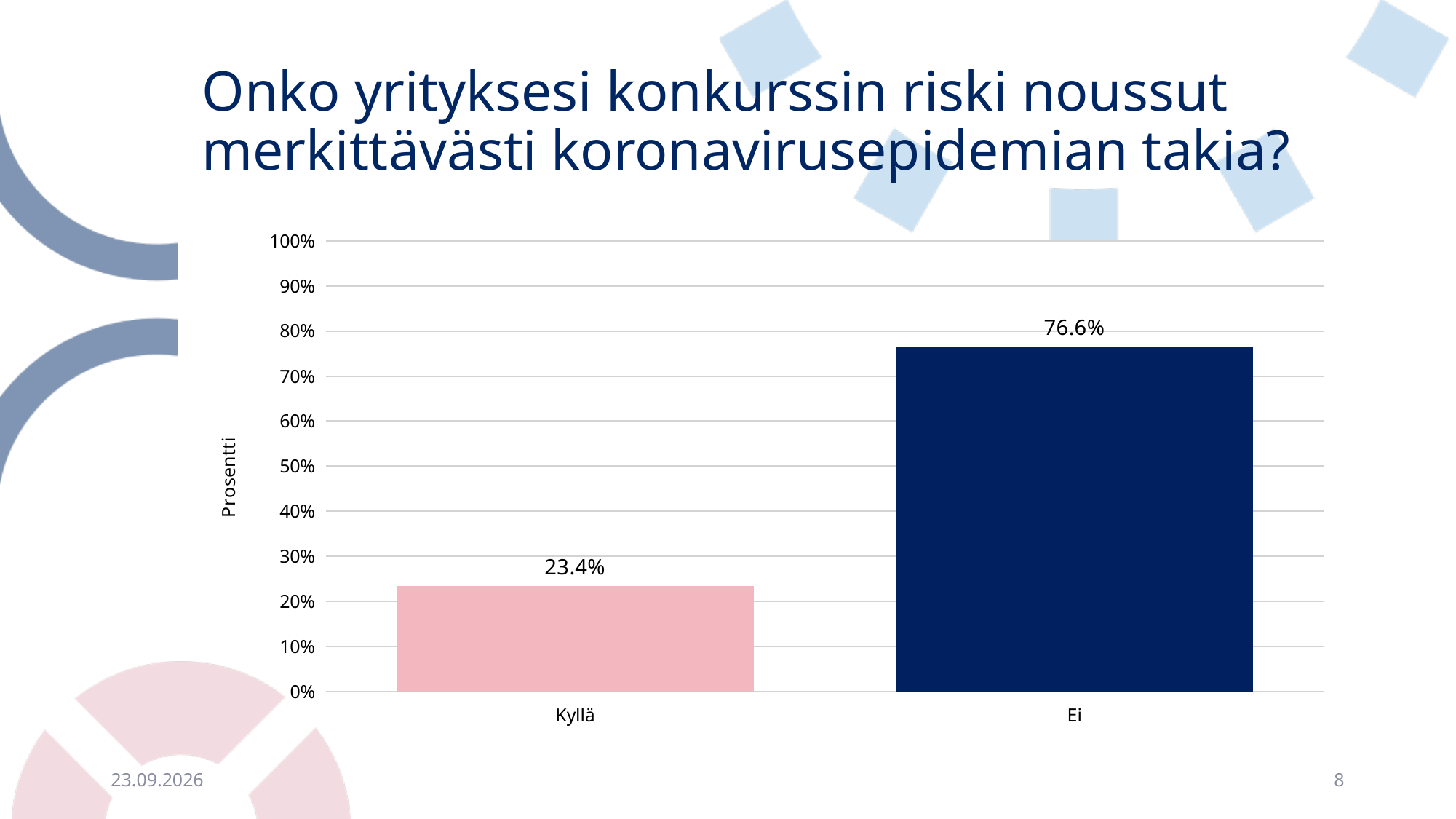
Is the value for Kyllä greater or less than 30%? less Is the value for Ei greater or less than 70%? greater Which category has the lowest value? Kyllä What is the difference between the values for Ei and Kyllä? 53.2% What is the label of the y axis? Prosentti What is the value for Ei? 76.6% What is the value for Kyllä? 23.4% How many categories are shown on the x axis? 2 What is the highest value shown on the y axis? 100% Which is larger, the value for Kyllä or the value for Ei? Ei Which category has the highest value? Ei What kind of chart is shown on the slide? bar chart